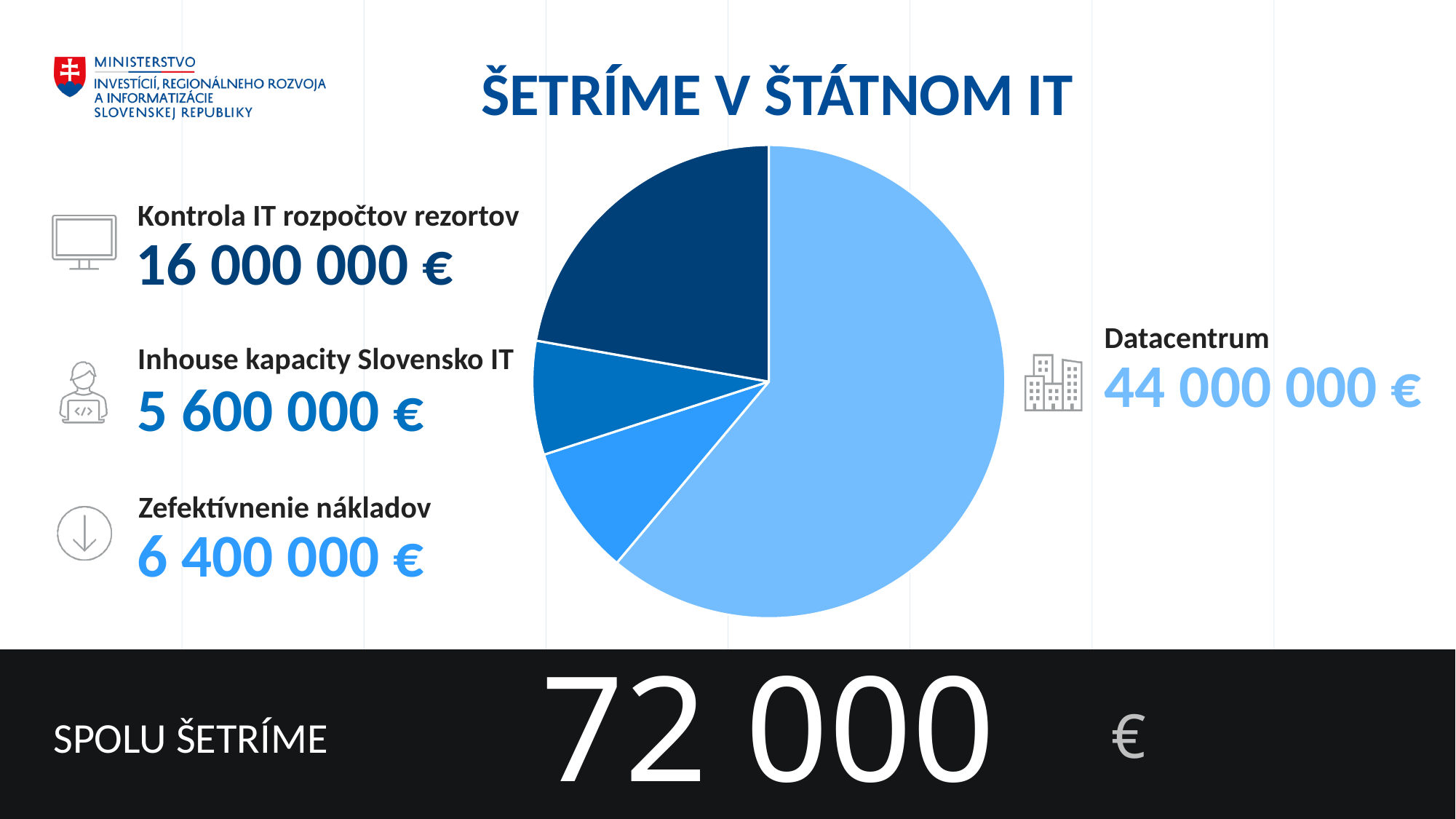
What kind of chart is shown on the slide? Pie chart What is the difference between the Datacentrum value and the Kontrola IT rozpočtov rezortov value? 28 000 000 € What is the value for Inhouse kapacity Slovensko IT? 5 600 000 € What is the difference between Zefektívnenie nákladov and Inhouse kapacity Slovensko IT? 800 000 € Which category has the largest slice of the pie chart? Datacentrum What is the title of the slide containing the chart? ŠETRÍME V ŠTÁTNOM IT How many categories are shown in the pie chart? 4 Which category has the smallest slice of the pie chart? Inhouse kapacity Slovensko IT What is the value for Datacentrum in the pie chart? 44 000 000 € Which is larger, Zefektívnenie nákladov or Inhouse kapacity Slovensko IT? Zefektívnenie nákladov What is the value for Kontrola IT rozpočtov rezortov? 16 000 000 € What is the value for Zefektívnenie nákladov? 6 400 000 €